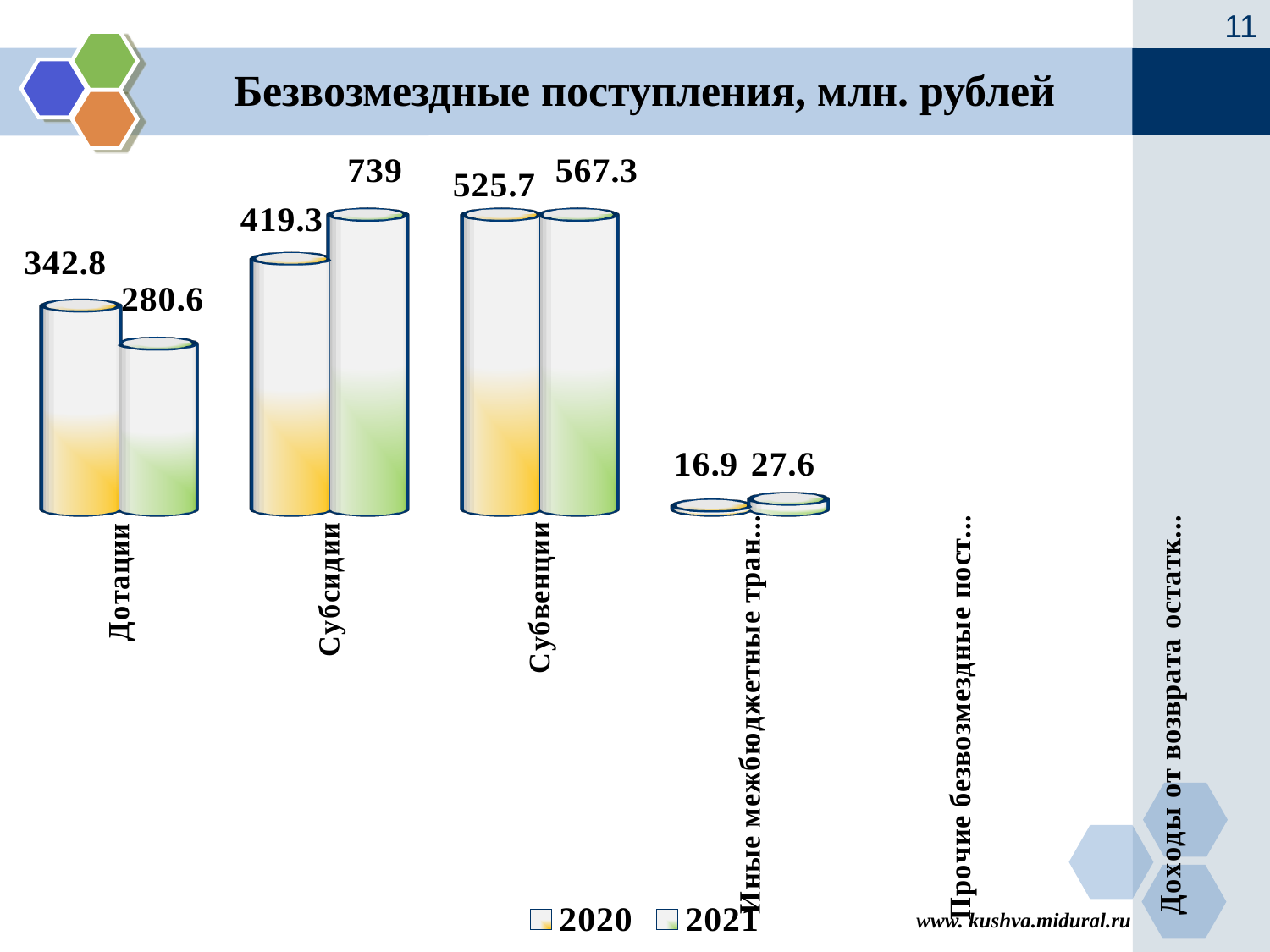
What is the value for Субсидии in 2021? 739 What is the value for Субвенции in 2020? 525.7 What kind of chart is shown on the slide? Bar chart What is the difference between the 2021 and 2020 values for Субсидии? 319.7 What is the difference between the 2020 and 2021 values for Дотации? 62.2 How many series does the legend list? 2 What is the value for Дотации in 2020? 342.8 Which is larger for Субвенции: the 2020 value or the 2021 value? 2021 What is the 2021 value for the category labelled 'Иные межбюджетные тран...'? 27.6 What is the title of the chart? Безвозмездные поступления, млн. рублей Which category has the highest 2021 value? Субсидии Which category has the lowest 2020 value among those with labelled bars? Иные межбюджетные тран...